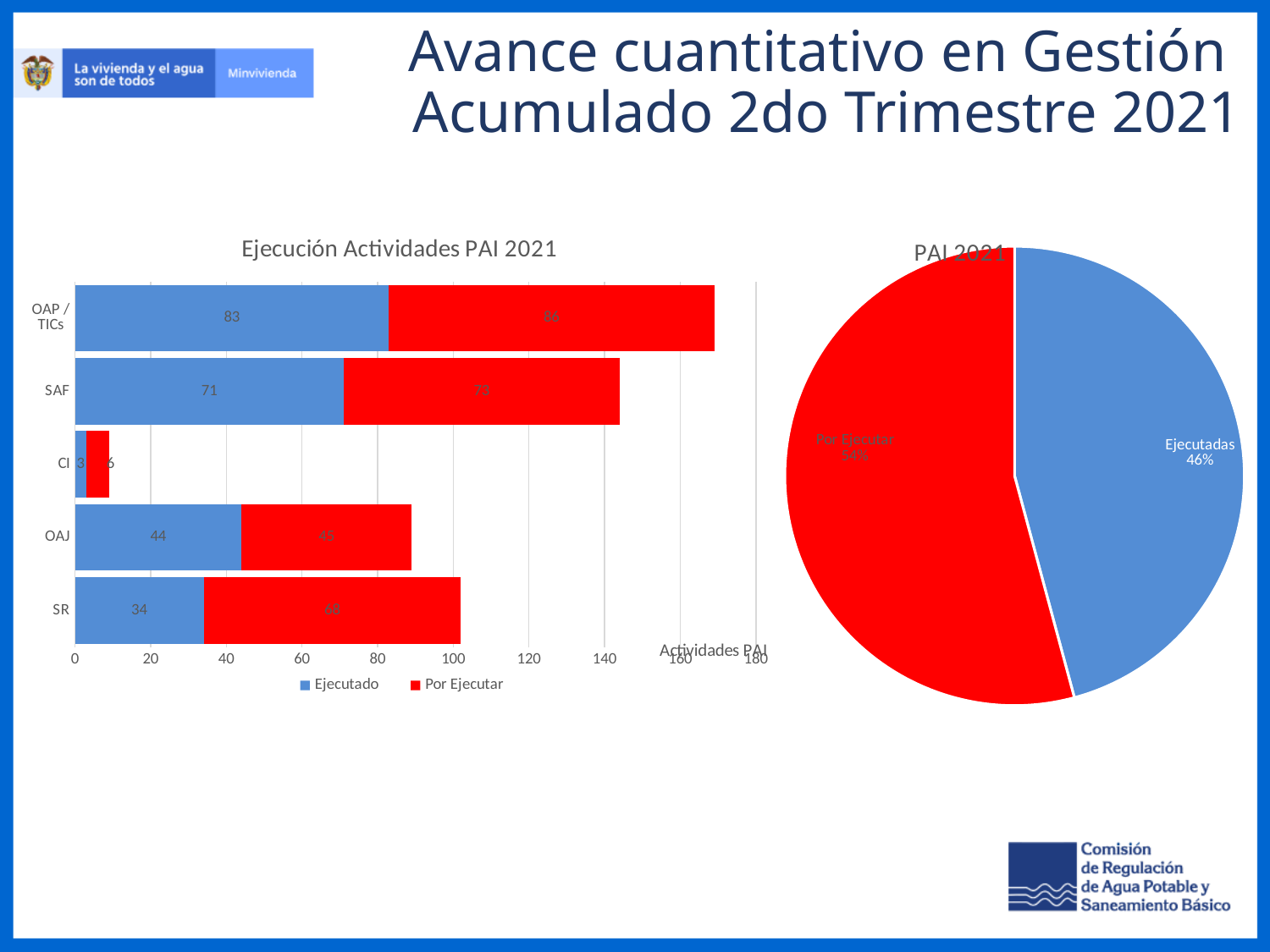
In the 'Ejecución Actividades PAI 2021' chart, which category has the highest Ejecutado value? OAP / TICs In the 'Ejecución Actividades PAI 2021' chart, what is the Ejecutado value for SAF? 71 In the 'Ejecución Actividades PAI 2021' chart, what is the total of the stacked bar for OAJ? 89 In the 'Ejecución Actividades PAI 2021' chart, what is the Por Ejecutar value for SR? 68 In the 'Ejecución Actividades PAI 2021' chart, is the Ejecutado value for SAF larger than the Ejecutado value for OAJ? Yes In the 'Ejecución Actividades PAI 2021' chart, what is the Ejecutado value for OAP / TICs? 83 What type of chart is 'Ejecución Actividades PAI 2021'? Stacked bar chart How many series does the legend of the 'Ejecución Actividades PAI 2021' chart list? 2 In the 'Ejecución Actividades PAI 2021' chart, what is the difference between the Por Ejecutar and Ejecutado values for SR? 34 How many categories are shown in the 'Ejecución Actividades PAI 2021' chart? 5 In the 'Ejecución Actividades PAI 2021' chart, which category has the lowest Por Ejecutar value? CI In the 'PAI 2021' pie chart, what share is labelled Ejecutadas? 46%